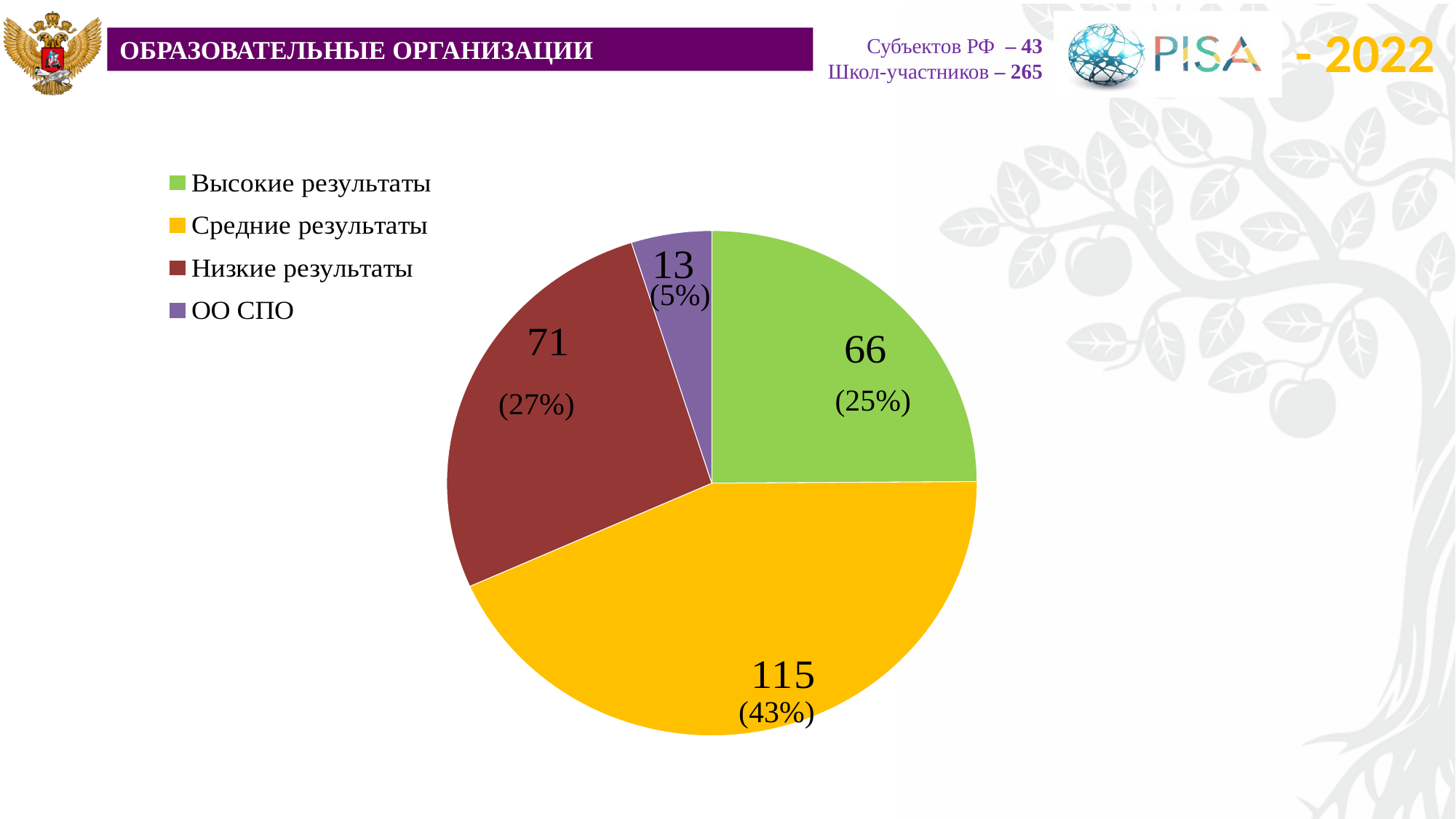
Which category has the largest slice? Средние результаты What kind of chart is shown on the slide? pie chart What is the value for Низкие результаты? 71 What share of the pie does Высокие результаты represent? 25% What is the difference between the values for Средние результаты and Низкие результаты? 44 Which category has the smallest slice? ОО СПО What is the value for ОО СПО? 13 What is the value for Высокие результаты? 66 How many slices does the pie chart have? 4 What is the value for Средние результаты? 115 What share of the pie does Низкие результаты represent? 27% Which colour represents ОО СПО in the legend? purple